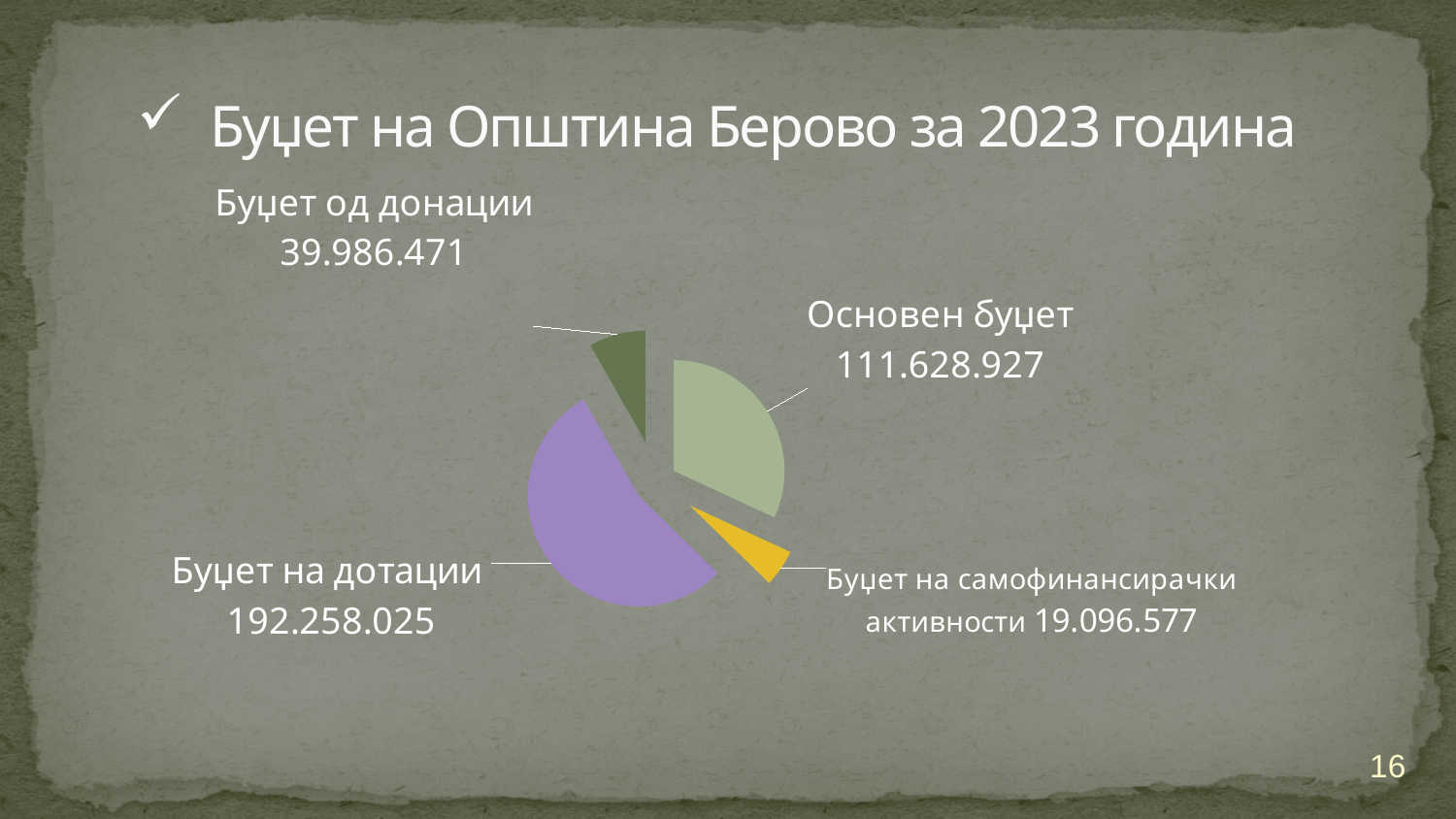
Which category has the largest slice of the pie? Буџет на дотации What is the value for Буџет од донации? 39.986.471 Which category has the smallest slice of the pie? Буџет на самофинансирачки активности What is the value for Основен буџет? 111.628.927 What is the difference between Буџет на дотации and Основен буџет? 80.629.098 What is the value for Буџет на самофинансирачки активности? 19.096.577 What kind of chart is shown on the slide? pie chart What colour is the slice for Буџет на самофинансирачки активности? yellow How many slices does the pie chart have? 4 What is the total of all four slices in the pie chart? 362.970.000 Which is larger, Основен буџет or Буџет од донации? Основен буџет What is the value for Буџет на дотации? 192.258.025